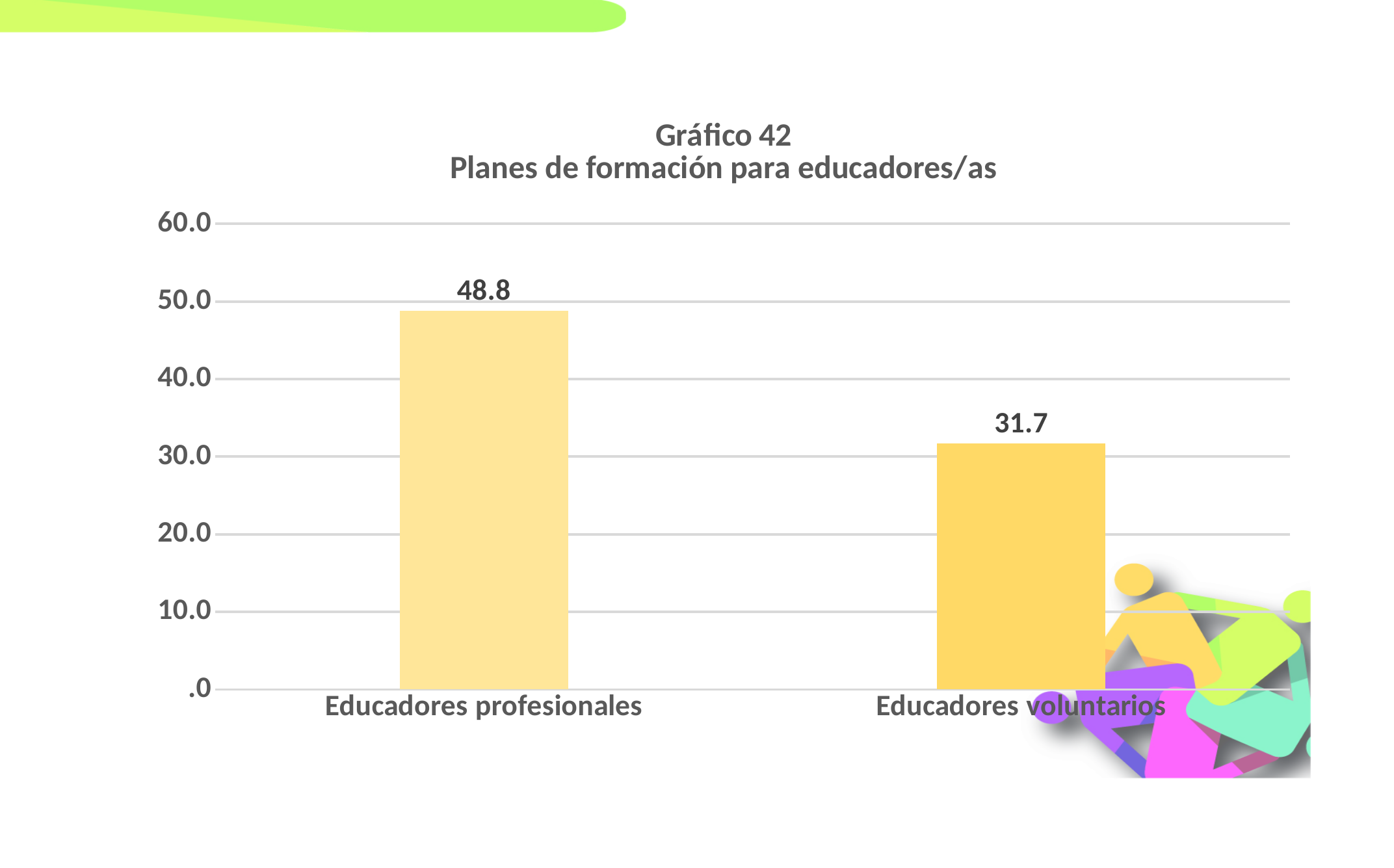
Which is larger, the value for Educadores profesionales or for Educadores voluntarios? Educadores profesionales How many categories are shown on the x axis? 2 Is the value for Educadores voluntarios greater or less than 40.0? less What is the title of the chart? Gráfico 42 Planes de formación para educadores/as What is the highest value shown on the y axis? 60.0 What is the value for Educadores profesionales? 48.8 What kind of chart is shown on the slide? bar chart What is the difference between the values for Educadores profesionales and Educadores voluntarios? 17.1 Which category has the lowest value? Educadores voluntarios What is the value for Educadores voluntarios? 31.7 Is the value for Educadores profesionales greater or less than 40.0? greater Which category has the highest value? Educadores profesionales